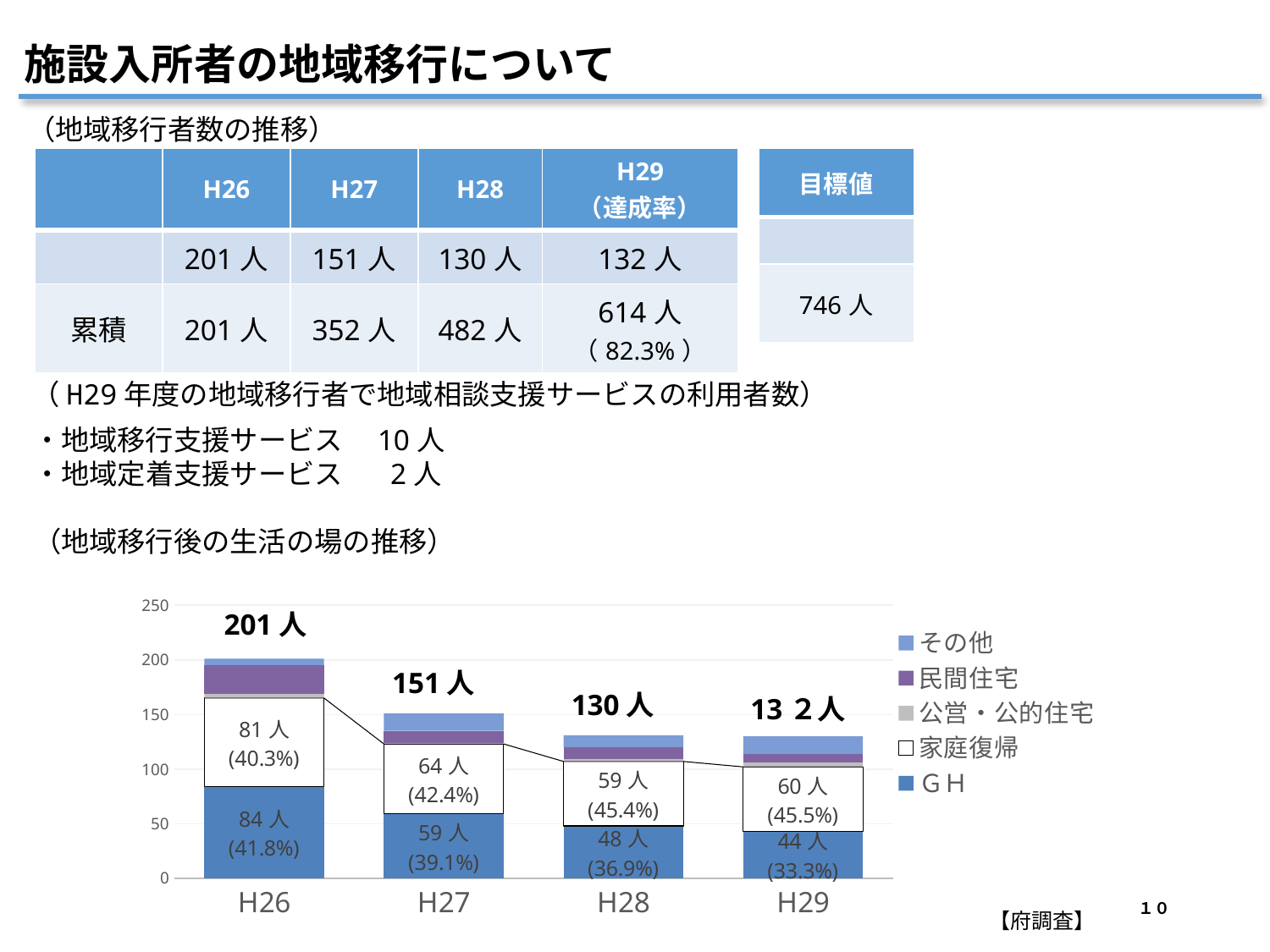
In H28, which is larger: the value for 家庭復帰 or the value for ＧＨ? 家庭復帰 Do the ＧＨ values rise or fall from H26 to H29? fall What kind of chart is shown on the slide? stacked bar chart How many series does the legend list? 5 Which year has the lowest value for ＧＨ? H29 Which year has the highest total bar? H26 What is the value for ＧＨ in H26? 84人 How many years are shown on the x axis of the chart? 4 What is the total of the stacked bar for H27? 151人 Is the total for H27 greater or less than 100? greater What is the value for 家庭復帰 in H29? 60人 What is the difference between the ＧＨ value in H26 and the ＧＨ value in H29? 40人